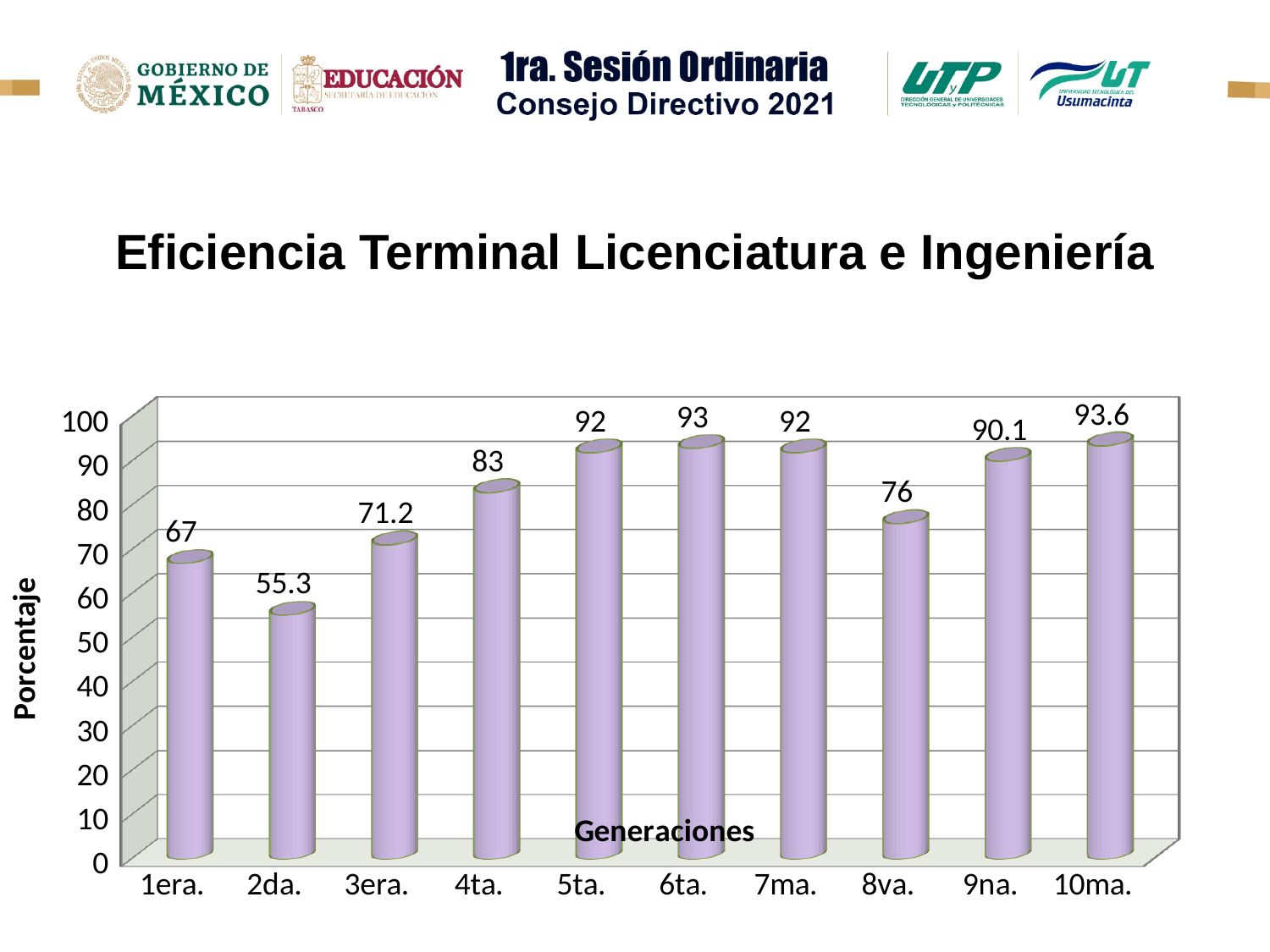
What is the value for the 9na. generation? 90.1 Which generation has the highest value? 10ma. What kind of chart is shown on the slide? bar chart Which generation has the lowest value? 2da. What is the title of the chart? Eficiencia Terminal Licenciatura e Ingeniería What is the value for the 4ta. generation? 83 Is the value for the 7ma. generation greater or less than 90? greater What is the value for the 2da. generation? 55.3 Which is larger, the value for the 8va. generation or the 4ta. generation? 4ta. What is the label of the y axis? Porcentaje What is the difference between the values for the 3era. and 1era. generations? 4.2 How many generations are shown on the x axis? 10